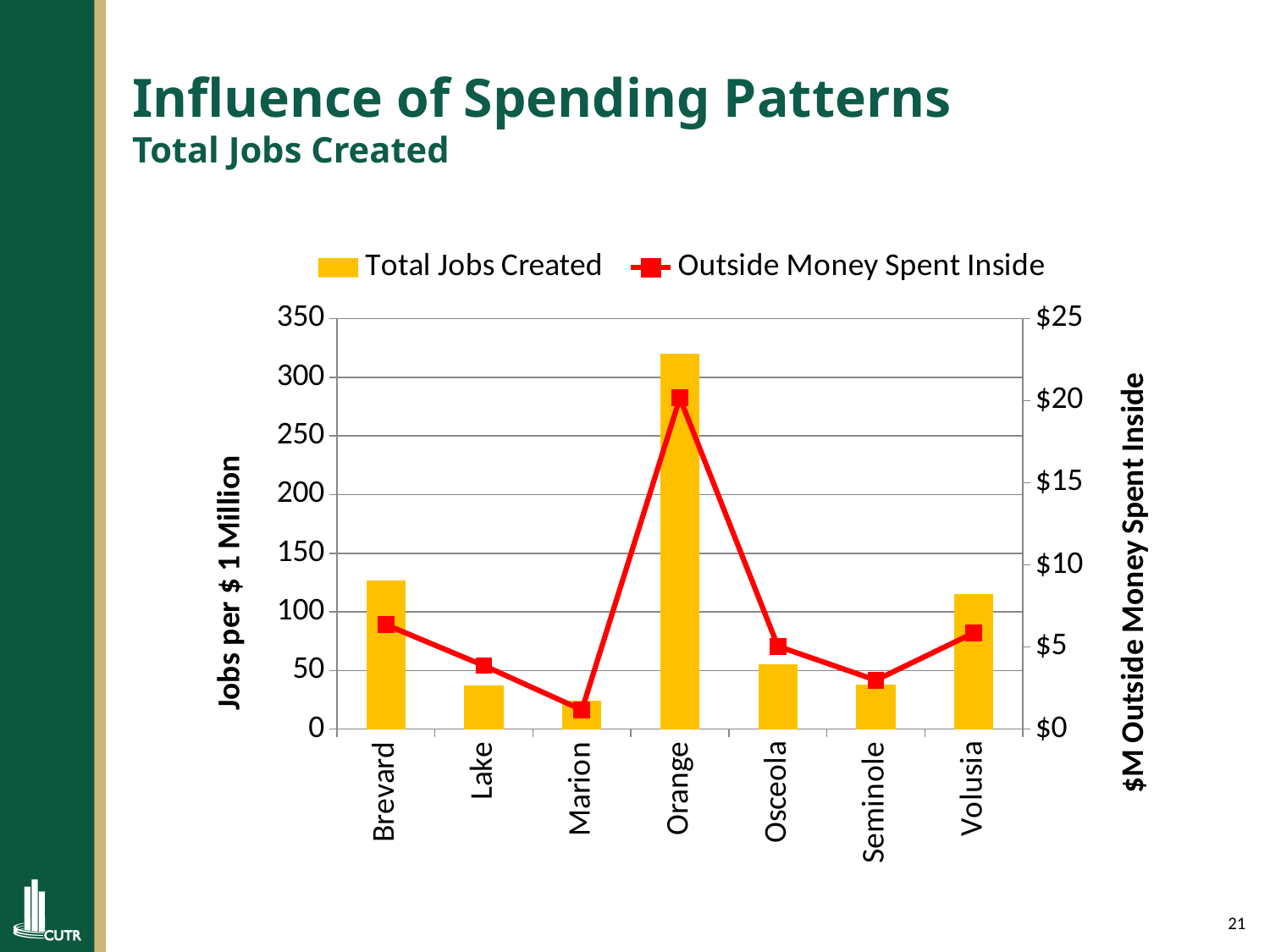
Is the Outside Money Spent Inside value for Marion greater or less than $5? less Is the Outside Money Spent Inside value for Orange greater or less than $15? greater Does the Outside Money Spent Inside line rise or fall from Brevard to Marion? fall Which county has the lowest Total Jobs Created bar? Marion How many series does the legend list? 2 Which county has the lowest value for Outside Money Spent Inside? Marion Is the Total Jobs Created value for Orange greater or less than 300? greater Which county has the highest Total Jobs Created bar? Orange How many counties are shown on the x axis? 7 Which county has the highest value for Outside Money Spent Inside? Orange Which county has more Total Jobs Created, Brevard or Lake? Brevard